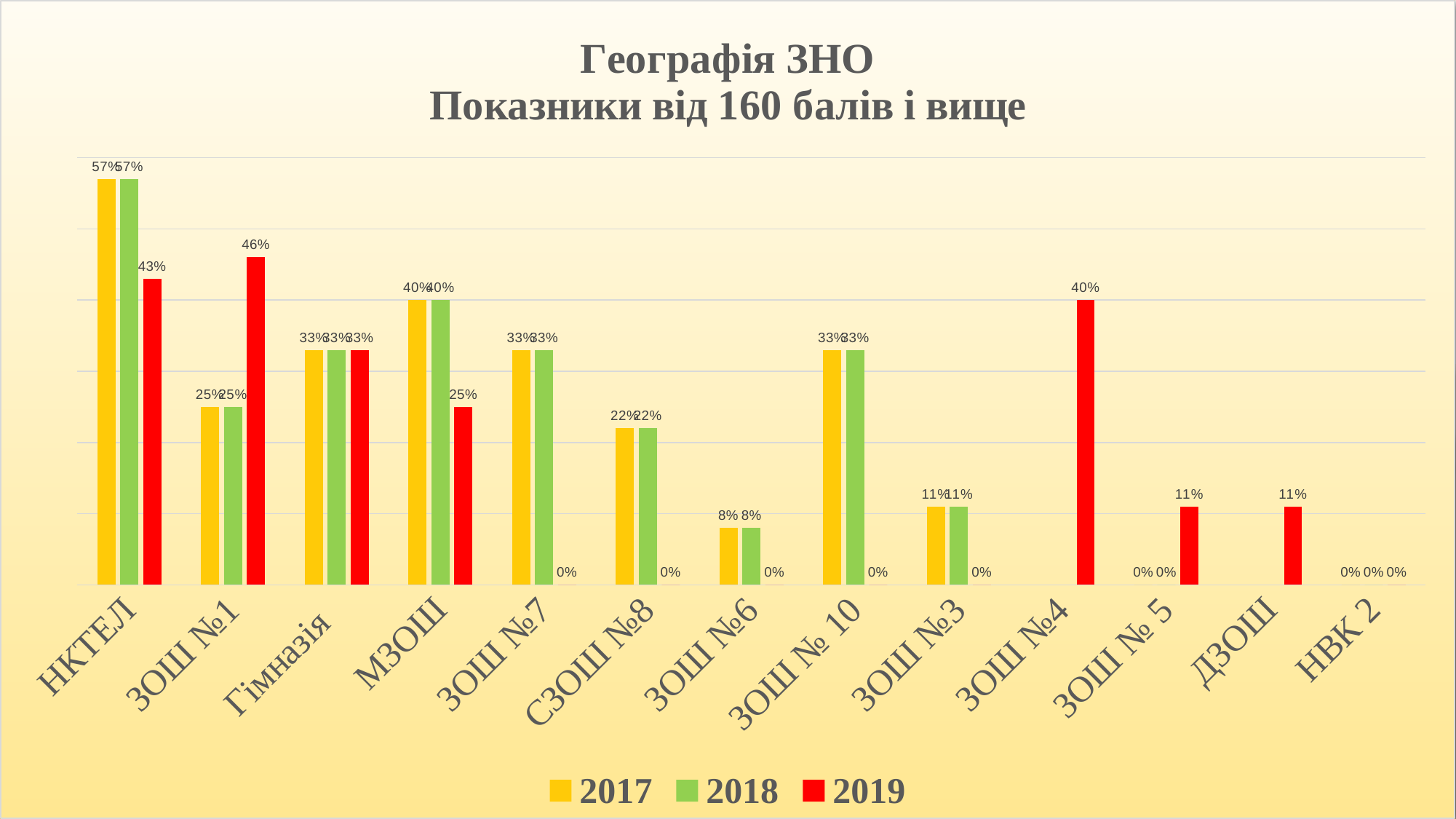
How many schools (categories) are shown on the x axis? 13 What is the 2019 value for НКТЕЛ? 43% Which school has the highest 2019 value? ЗОШ №1 Which is larger for МЗОШ: the 2018 value or the 2019 value? 2018 What is the 2019 value for ЗОШ №4? 40% How many series does the legend list? 3 Which school has the highest 2017 value? НКТЕЛ What is the difference between the 2018 and 2019 values for НКТЕЛ? 14% What type of chart is shown on the slide? bar chart What is the 2017 value for МЗОШ? 40% What is the 2019 value for ЗОШ №1? 46% What is the title of the chart? Географія ЗНО Показники від 160 балів і вище